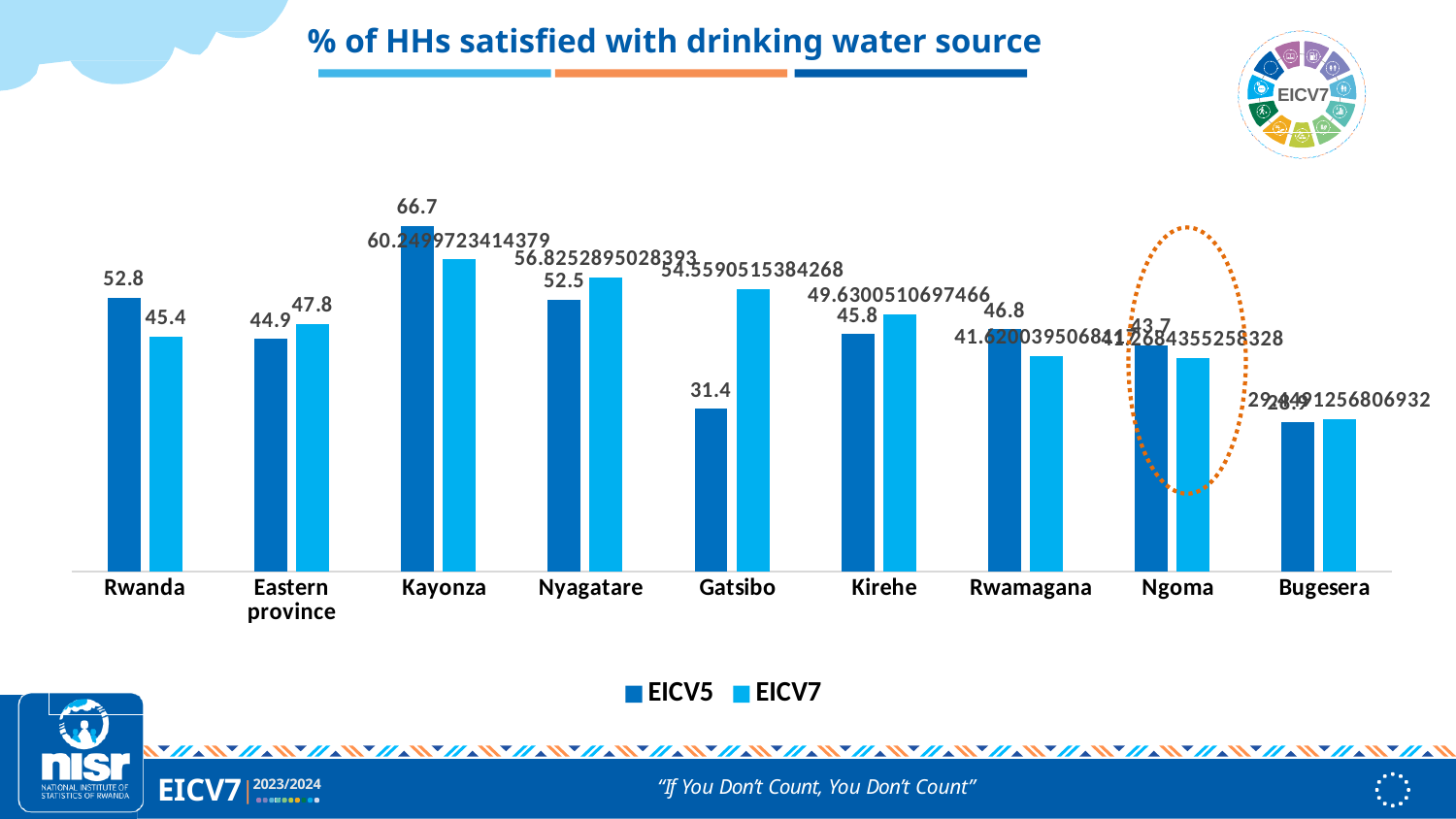
What kind of chart is shown on the slide? Bar chart What is the EICV5 value for Gatsibo? 31.4 What is the EICV5 value for Rwanda? 52.8 For Gatsibo, which is larger, the EICV5 value or the EICV7 value? EICV7 What is the difference between the EICV5 and EICV7 values for Rwanda? 7.4 What is the EICV7 value for Eastern province? 47.8 Which category has the highest EICV5 value? Kayonza Which category has the highest EICV7 value? Kayonza How many categories are shown on the x axis? 9 Which category has the lowest EICV5 value? Bugesera How many series does the legend list? 2 What is the EICV5 value for Kayonza? 66.7